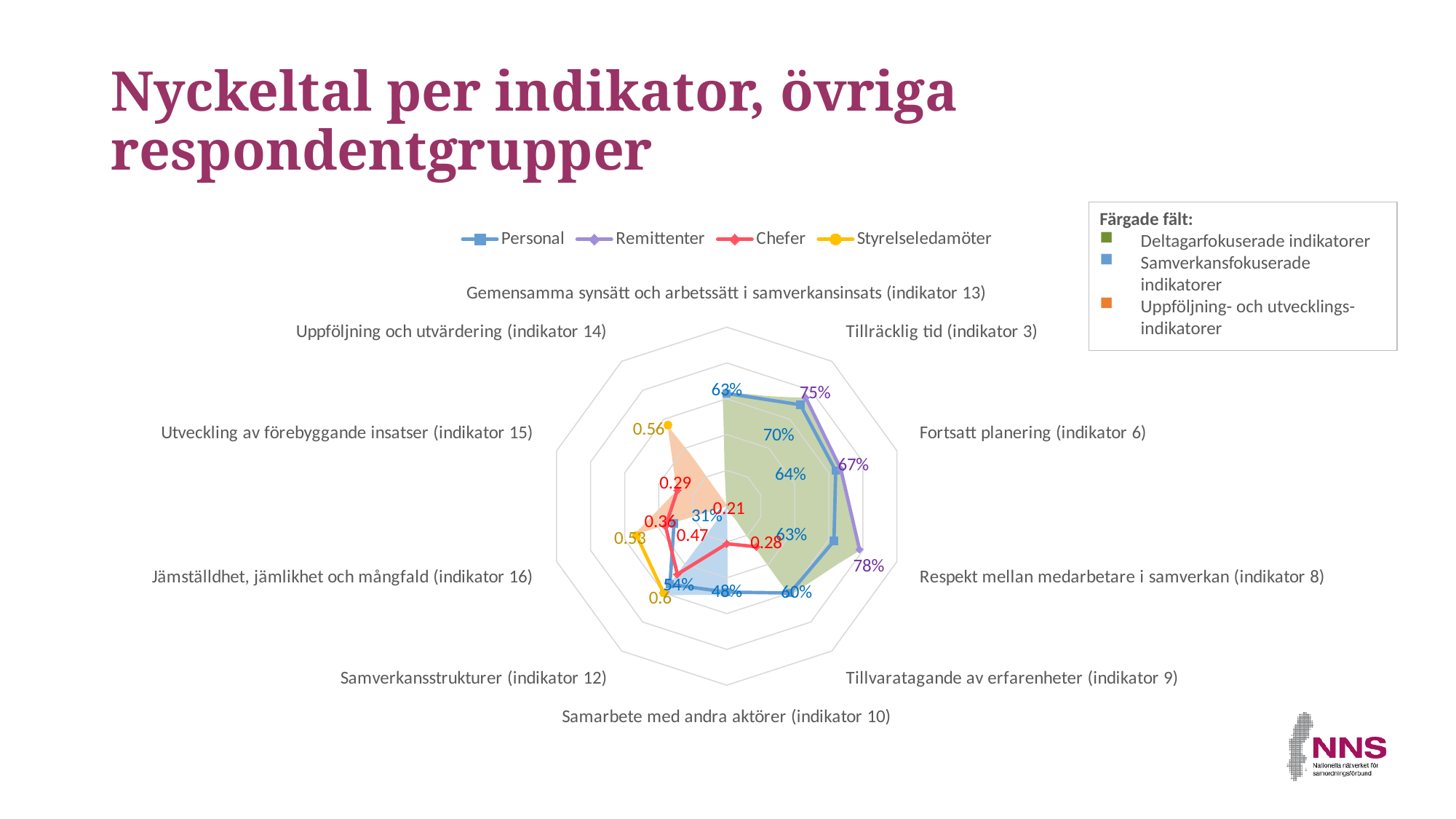
What is the value for Remittenter at Respekt mellan medarbetare i samverkan (indikator 8)? 78% What kind of chart is shown on the slide? Radar chart Which series are listed in the chart legend? Personal, Remittenter, Chefer, Styrelseledamöter What is the value for Personal at Samarbete med andra aktörer (indikator 10)? 48% What is the value for Styrelseledamöter at Uppföljning och utvärdering (indikator 14)? 0.56 Which is larger at Respekt mellan medarbetare i samverkan (indikator 8): Remittenter or Personal? Remittenter What is the highest labelled value for the Remittenter series? 78% How many series does the chart legend list? 4 How many indicator categories are plotted around the radar chart? 10 What is the difference between Remittenter (78%) and Personal (63%) at Respekt mellan medarbetare i samverkan (indikator 8)? 15 percentage points What is the value for Styrelseledamöter at Samverkansstrukturer (indikator 12)? 0.6 What is the value for Personal at Tillvaratagande av erfarenheter (indikator 9)? 60%